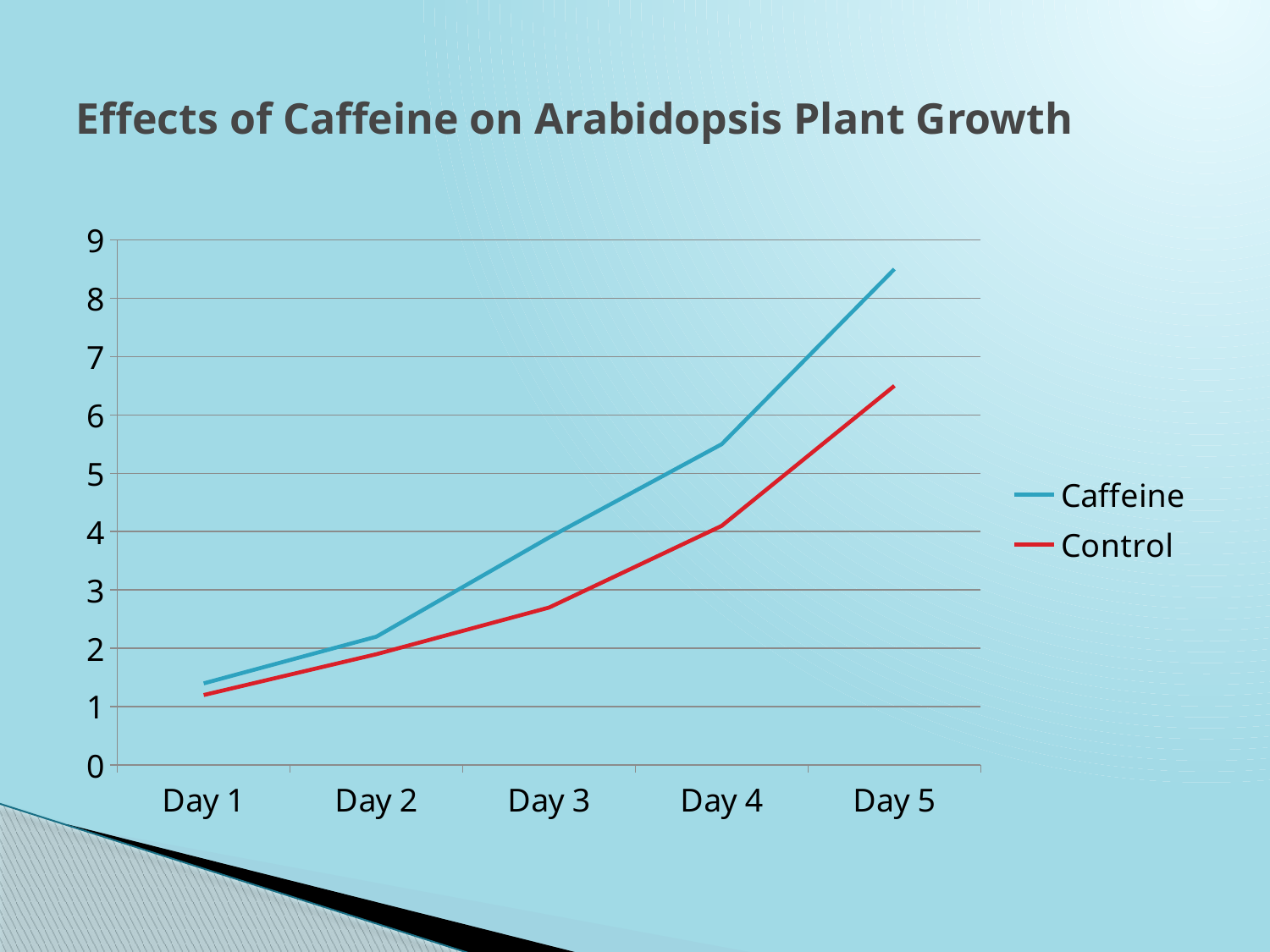
Is the Caffeine value on Day 5 greater or less than 8? greater Is the Control value on Day 3 greater or less than 3? less On Day 5, which series has the larger value, Caffeine or Control? Caffeine How many days are plotted along the x axis? 5 What kind of chart is shown on the slide? line chart On which day is the Control series at its lowest? Day 1 Do the Caffeine values rise or fall from Day 1 to Day 5? rise Is the Control value on Day 5 greater or less than 6? greater How many series does the legend list? 2 On which day is the Caffeine series at its highest? Day 5 What is the title of the chart? Effects of Caffeine on Arabidopsis Plant Growth